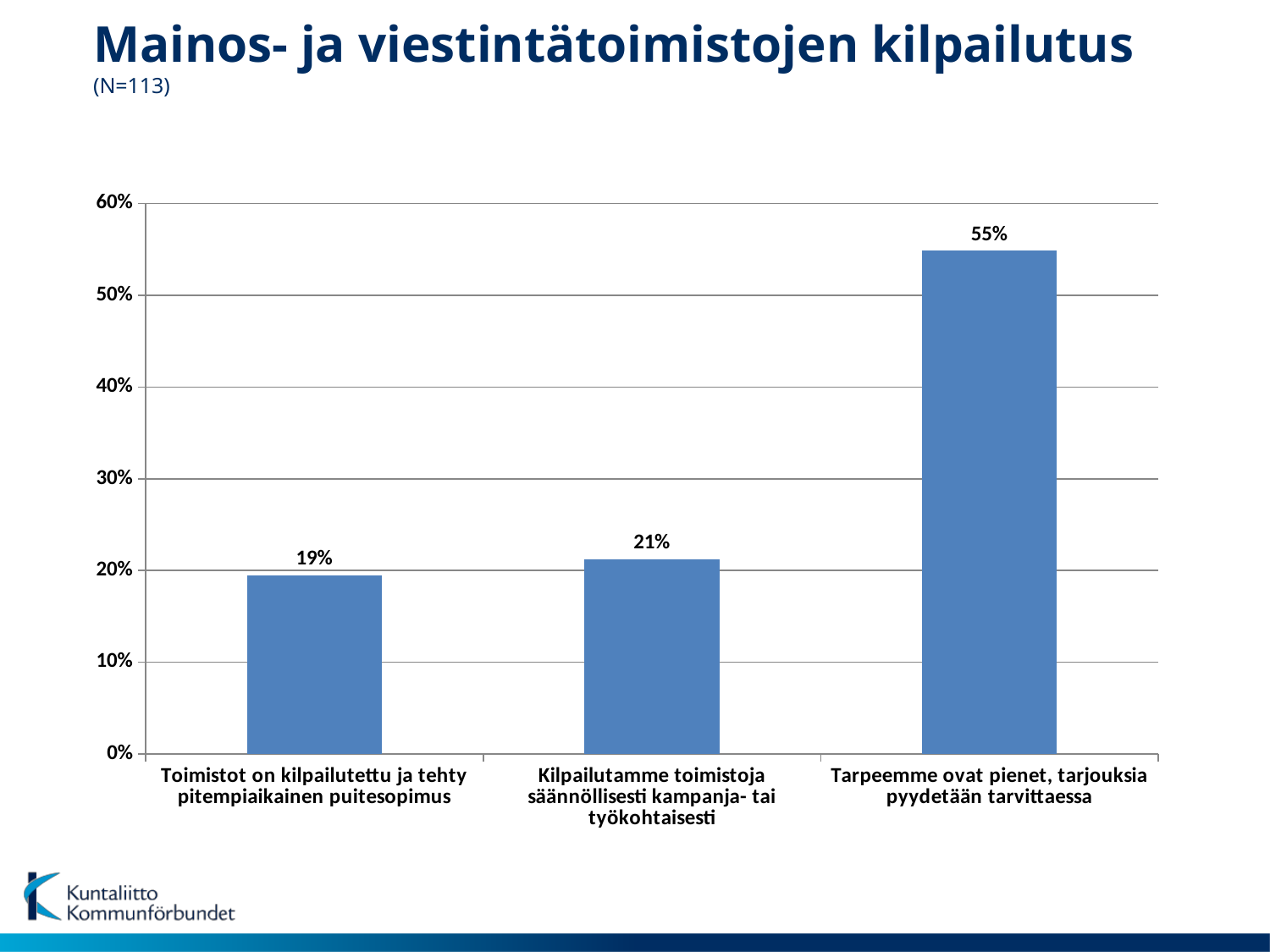
What is the value for "Kilpailutamme toimistoja säännöllisesti kampanja- tai työkohtaisesti"? 21% How many categories are shown in the chart? 3 Is the value for "Tarpeemme ovat pienet, tarjouksia pyydetään tarvittaessa" greater or less than 50%? greater Which category has the lowest value? Toimistot on kilpailutettu ja tehty pitempiaikainen puitesopimus What is the sample size (N) stated under the chart title? N=113 What kind of chart is shown on the slide? Bar chart What is the difference between the values for "Kilpailutamme toimistoja säännöllisesti kampanja- tai työkohtaisesti" and "Toimistot on kilpailutettu ja tehty pitempiaikainen puitesopimus"? 2% Which category has the highest value? Tarpeemme ovat pienet, tarjouksia pyydetään tarvittaessa What is the value for "Tarpeemme ovat pienet, tarjouksia pyydetään tarvittaessa"? 55% What is the value for "Toimistot on kilpailutettu ja tehty pitempiaikainen puitesopimus"? 19% Which is larger: the value for "Kilpailutamme toimistoja säännöllisesti kampanja- tai työkohtaisesti" or for "Toimistot on kilpailutettu ja tehty pitempiaikainen puitesopimus"? Kilpailutamme toimistoja säännöllisesti kampanja- tai työkohtaisesti What is the difference between the values for "Tarpeemme ovat pienet, tarjouksia pyydetään tarvittaessa" and "Kilpailutamme toimistoja säännöllisesti kampanja- tai työkohtaisesti"? 34%